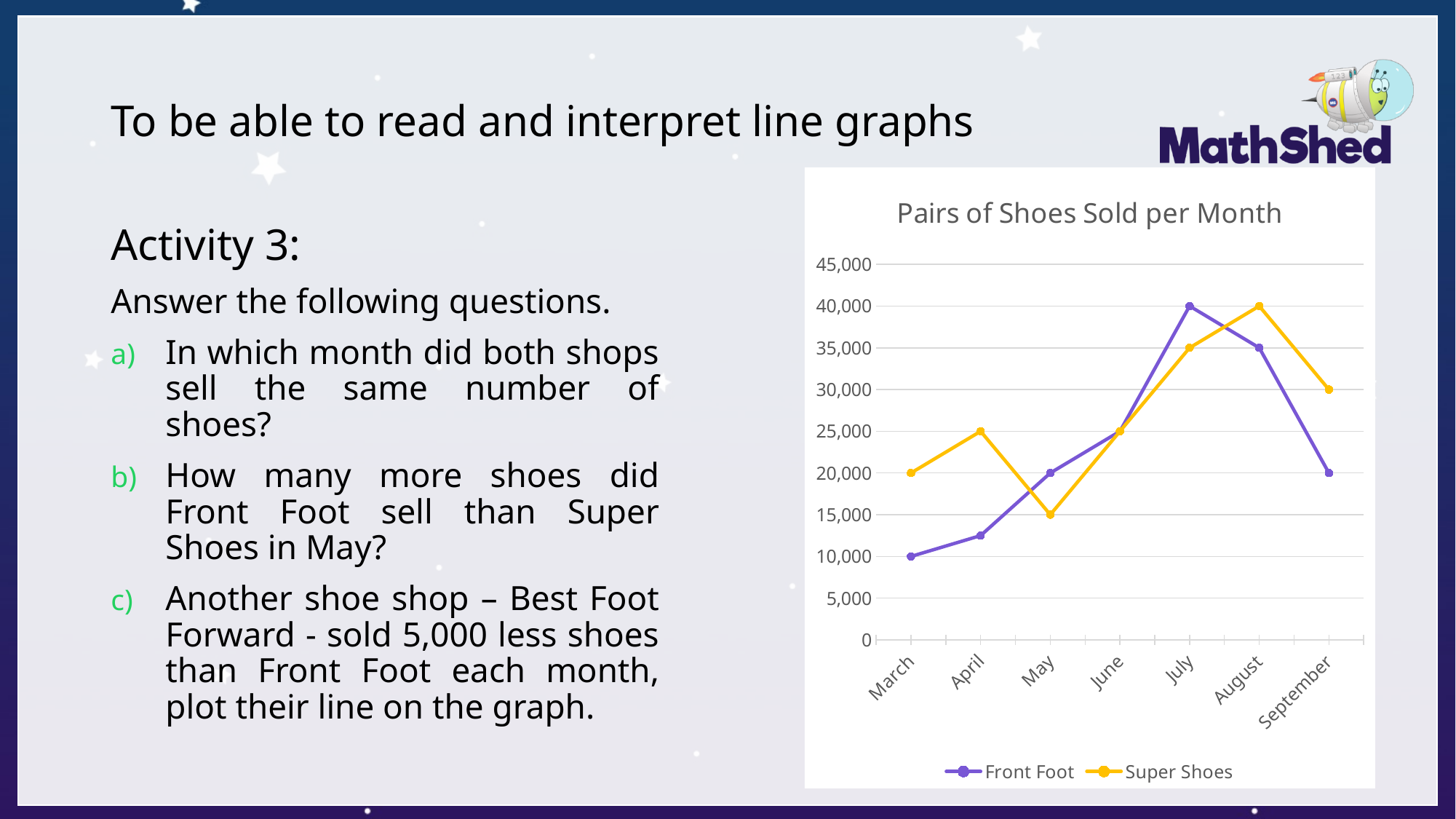
Is the value for Front Foot in April greater or less than 15,000? less Does the Front Foot line rise or fall from March to July? rise How many pairs of shoes did Super Shoes sell in May? 15,000 What is the title of the chart? Pairs of Shoes Sold per Month In which month did Front Foot sell the fewest pairs of shoes? March How many more pairs of shoes did Front Foot sell than Super Shoes in May? 5,000 Which shop sold more pairs of shoes in September, Front Foot or Super Shoes? Super Shoes In which month did Super Shoes sell the most pairs of shoes? August How many pairs of shoes did Front Foot sell in July? 40,000 How many months are shown on the x axis? 7 How many series does the legend list? 2 What type of chart is shown on the slide? line chart